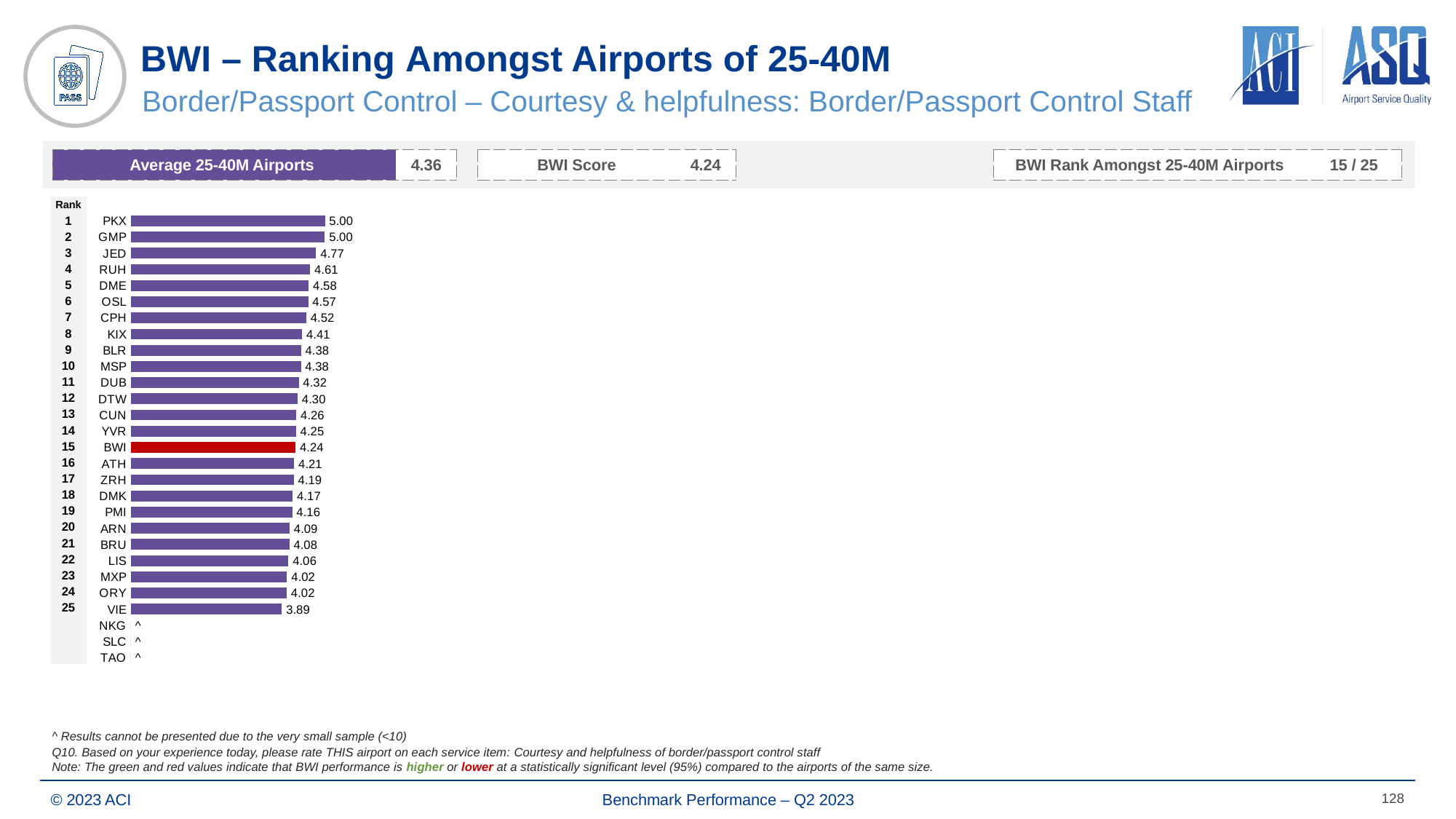
What is the difference between the values for RUH and ARN? 0.52 What is the value for VIE? 3.89 Which airport has the lowest plotted value? VIE What is the Average 25-40M Airports value shown on the slide? 4.36 Which bar is coloured red in the chart? BWI What is the difference between the values for PKX and BWI? 0.76 How many airports have a plotted bar in the chart? 25 What kind of chart is shown on the slide? bar chart Do the values rise or fall going down the ranked list from rank 1 to rank 25? fall What is the value for BWI? 4.24 What is the value for JED? 4.77 Which is larger, the value for CPH or the value for DUB? CPH